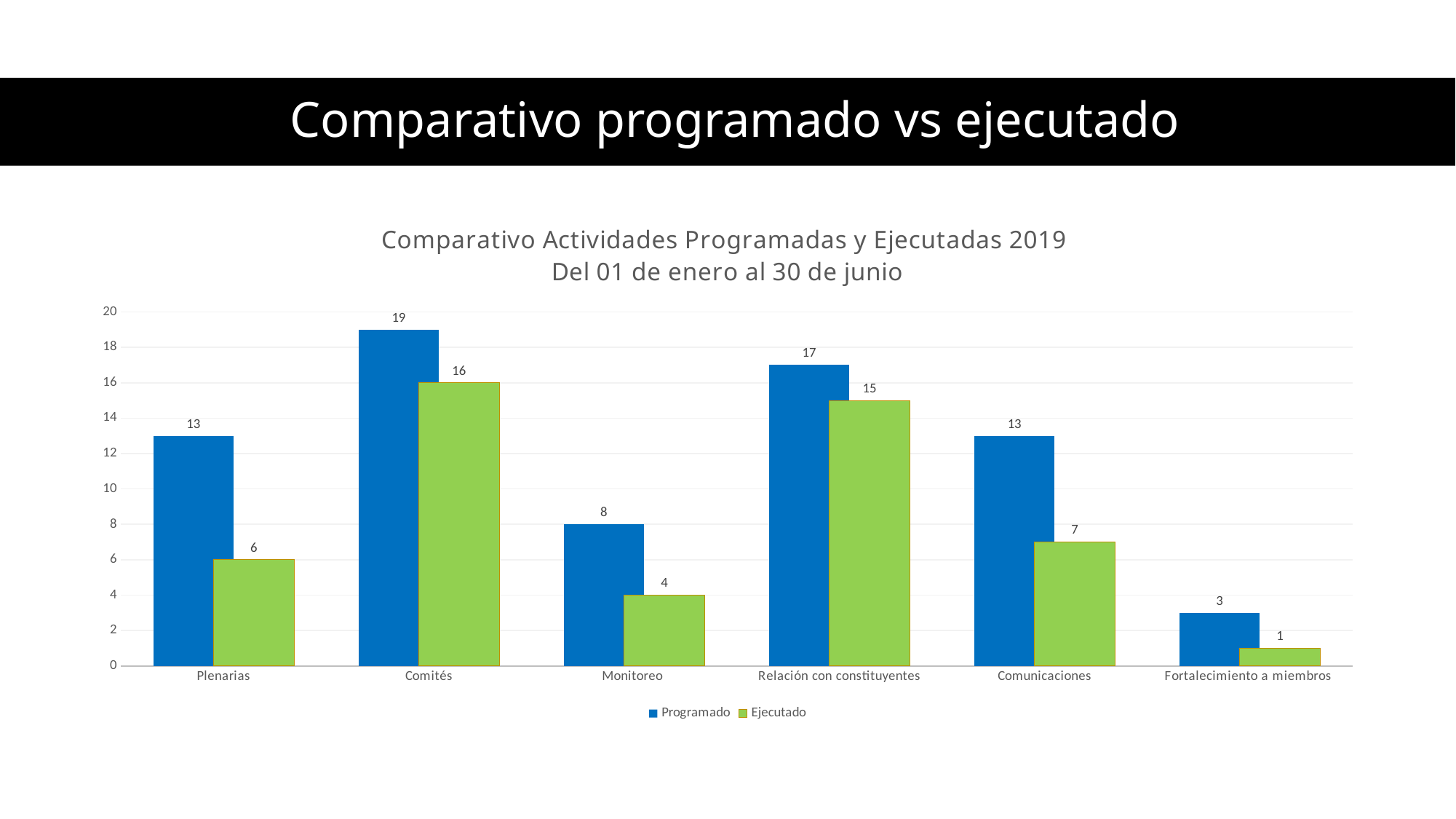
Which colour represents the Ejecutado series? Green What is the Programado value for Comités? 19 Which is larger, the Ejecutado value for Comités or the Programado value for Relación con constituyentes? Programado value for Relación con constituyentes How many categories are shown on the x axis? 6 What is the difference between the Programado and Ejecutado values for Plenarias? 7 What kind of chart is shown on the slide? Bar chart Which category has the highest Programado value? Comités Which category has the lowest Ejecutado value? Fortalecimiento a miembros What is the difference between the Programado and Ejecutado values for Comunicaciones? 6 How many series does the legend list? 2 What is the Ejecutado value for Plenarias? 6 What is the Ejecutado value for Fortalecimiento a miembros? 1